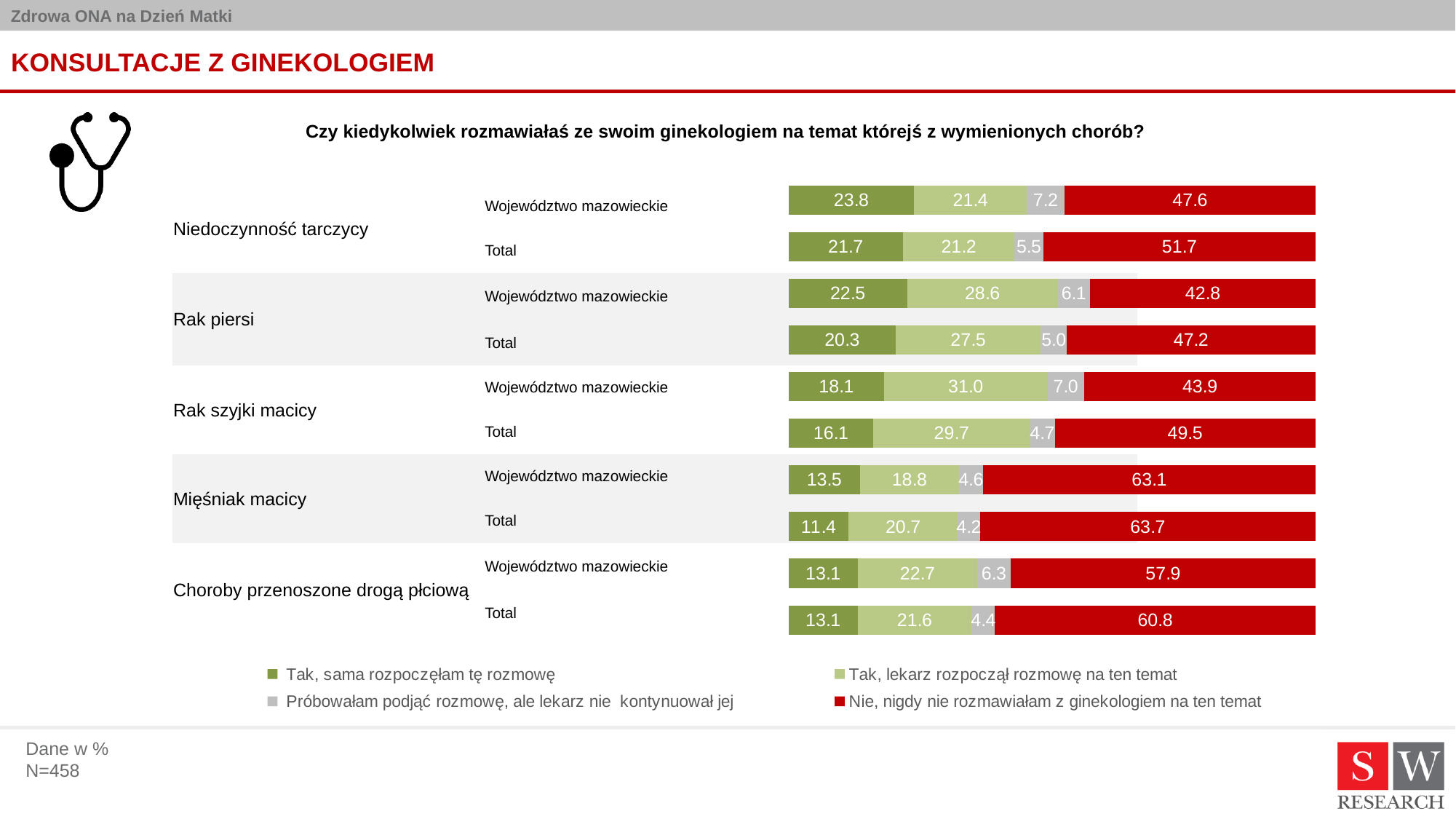
What kind of chart is shown on the slide? Stacked bar chart What is the value of "Tak, lekarz rozpoczął rozmowę na ten temat" for Rak piersi, Total? 27.5 How many series does the legend list? 4 For Mięśniak macicy, what is the difference in "Nie, nigdy nie rozmawiałam z ginekologiem na ten temat" between Total and Województwo mazowieckie? 0.6 What is the value of "Nie, nigdy nie rozmawiałam z ginekologiem na ten temat" for Niedoczynność tarczycy, Województwo mazowieckie? 47.6 What is the total of the stacked bar for Mięśniak macicy, Województwo mazowieckie? 100.0 For Rak szyjki macicy, what is the difference in "Tak, lekarz rozpoczął rozmowę na ten temat" between Województwo mazowieckie and Total? 1.3 What is the value of "Próbowałam podjąć rozmowę, ale lekarz nie kontynuował jej" for Choroby przenoszone drogą płciową, Województwo mazowieckie? 6.3 How many bars are plotted in the chart? 10 Which bar has the lowest value for "Tak, sama rozpoczęłam tę rozmowę"? Mięśniak macicy, Total For Rak piersi, which has the larger value of "Nie, nigdy nie rozmawiałam z ginekologiem na ten temat": Województwo mazowieckie or Total? Total Which bar has the highest value for "Nie, nigdy nie rozmawiałam z ginekologiem na ten temat"? Mięśniak macicy, Total